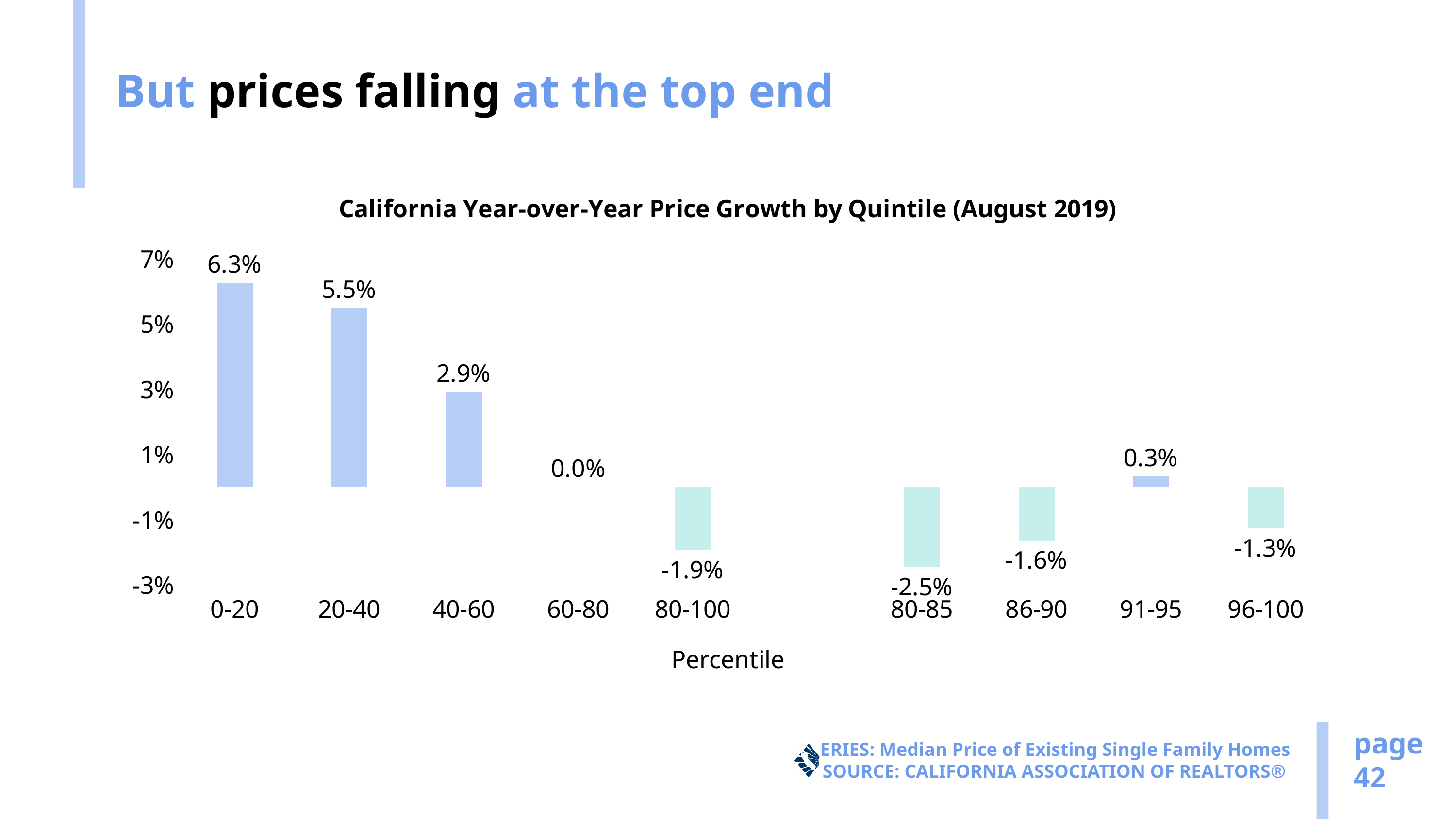
What kind of chart is shown on the slide? Bar chart Which has a larger year-over-year price growth, the 40-60 percentile or the 96-100 percentile? 40-60 Do the values for the first five quintiles (0-20 through 80-100) rise or fall from left to right? Fall What is the year-over-year price growth for the 80-85 percentile? -2.5% Which percentile group has the highest year-over-year price growth? 0-20 What is the year-over-year price growth for the 60-80 percentile? 0.0% What is the difference between the price growth for the 0-20 percentile and the 20-40 percentile? 0.8% How many percentile categories are shown on the x axis? 9 What is the title of the chart? California Year-over-Year Price Growth by Quintile (August 2019) What is the year-over-year price growth for the 91-95 percentile? 0.3% What is the year-over-year price growth for the 0-20 percentile? 6.3% Which percentile group has the lowest year-over-year price growth? 80-85